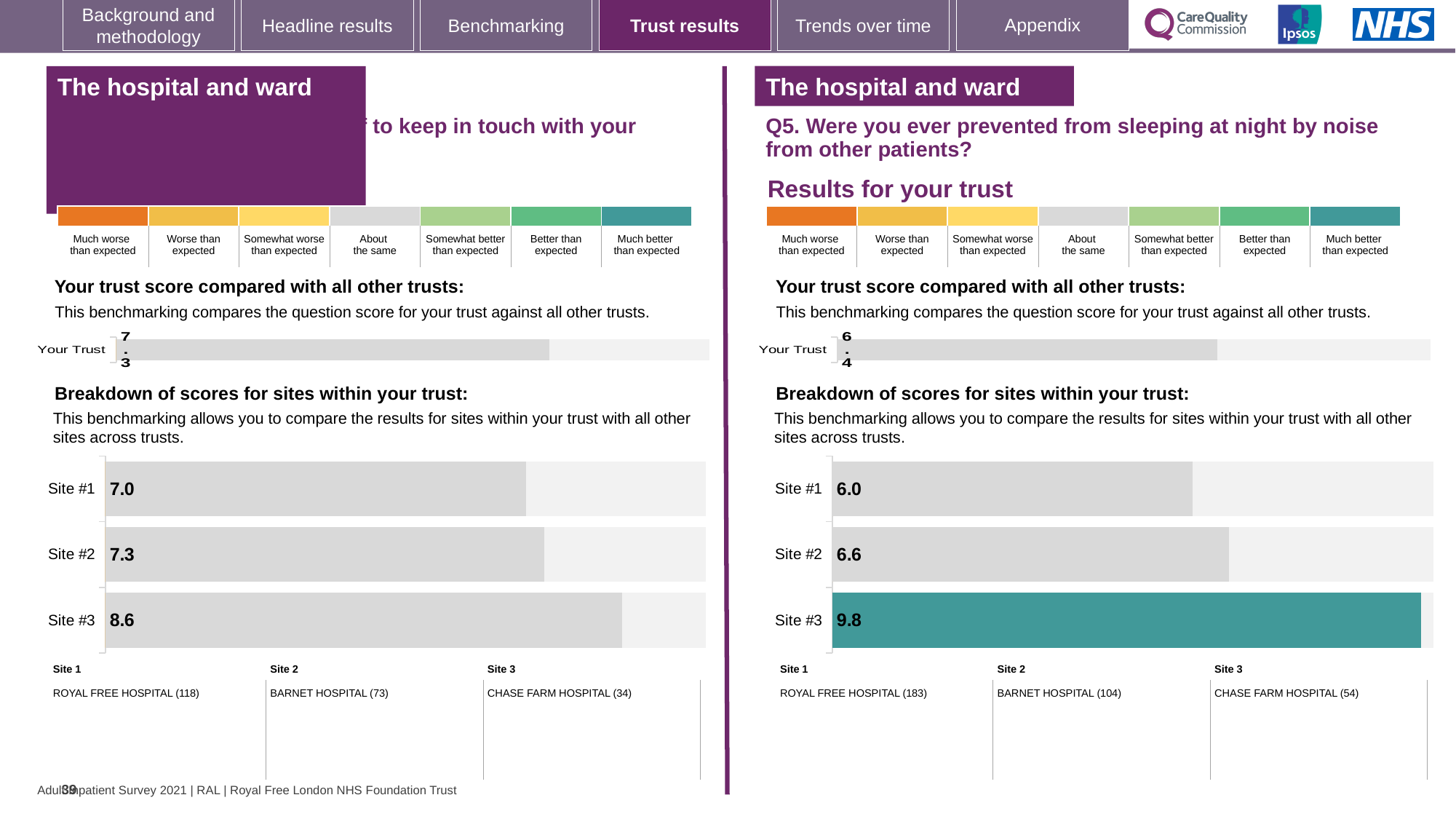
On the left-hand site breakdown chart, what is the score for Site #3? 8.6 On the right-hand Q5 site breakdown chart, what is the score for Site #1? 6.0 On the right-hand Q5 'Your trust score' chart, what is the score shown for Your Trust? 6.4 On the right-hand Q5 site breakdown chart, what is the difference between the scores for Site #3 and Site #2? 3.2 What type of chart is used for the site breakdown on the right-hand side of the slide? Bar chart On the left-hand site breakdown chart, how many sites are shown? 3 On the right-hand chart for Q5 (prevented from sleeping at night by noise from other patients), what is the score for Site #3? 9.8 On the left-hand site breakdown chart, which site has the highest score? Site #3 On the left-hand site breakdown chart, what is the score for Site #1? 7.0 On the right-hand Q5 site breakdown chart, which site has the lowest score? Site #1 On the left-hand site breakdown chart, what is the difference between the scores for Site #3 and Site #1? 1.6 On the right-hand Q5 site breakdown chart, which site has the highest score? Site #3